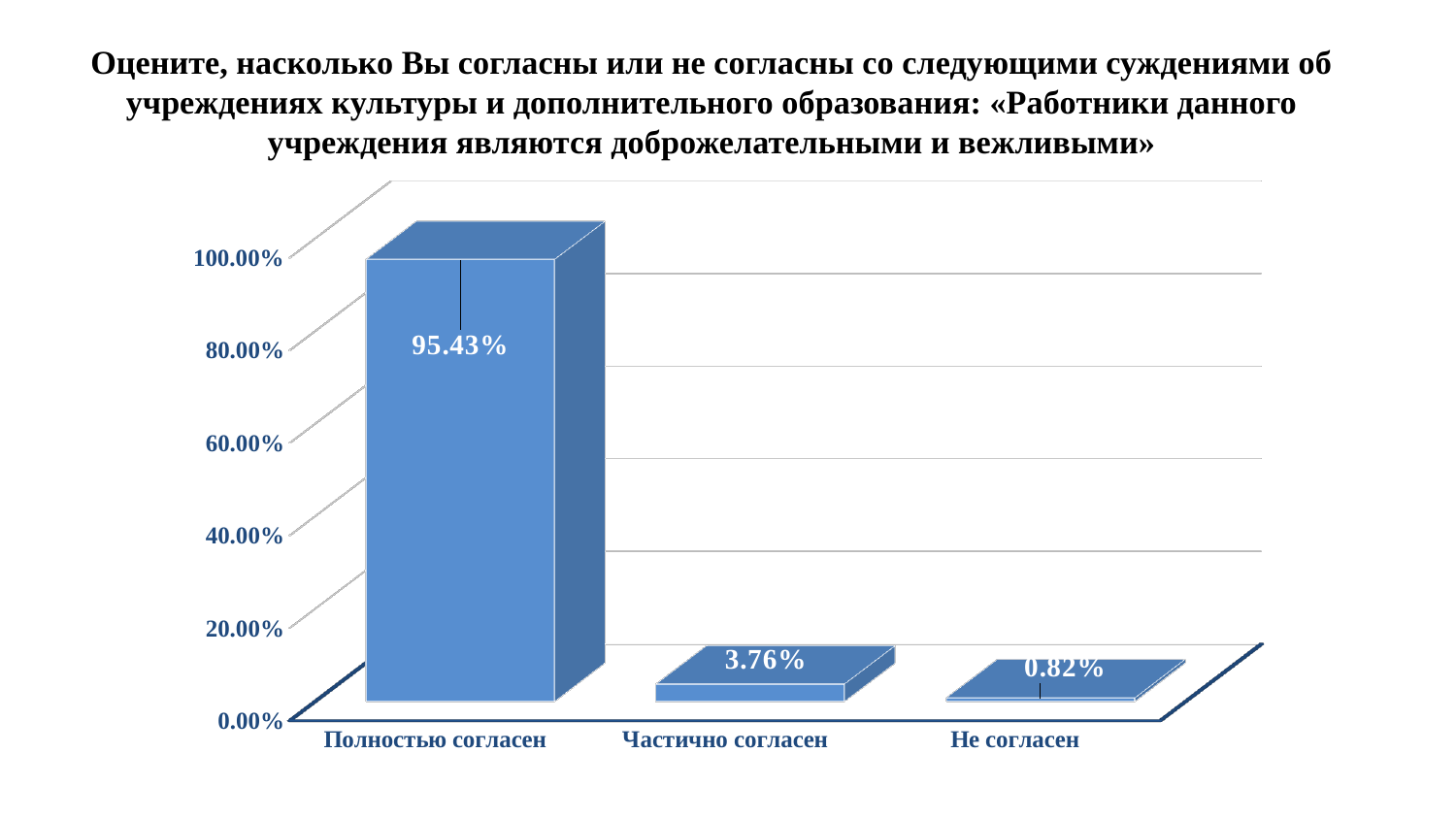
What is the difference between the values for «Частично согласен» and «Не согласен»? 2.94% Is the value for «Полностью согласен» greater or less than 80.00%? greater Which is larger, the value for «Частично согласен» or the value for «Не согласен»? Частично согласен Which category has the highest value? Полностью согласен How many categories are shown on the chart? 3 What is the difference between the values for «Полностью согласен» and «Частично согласен»? 91.67% Do the values rise or fall from left to right along the x axis? fall What is the value for «Не согласен»? 0.82% What is the value for «Частично согласен»? 3.76% What is the value for «Полностью согласен»? 95.43% Which category has the lowest value? Не согласен What kind of chart is shown on the slide? bar chart